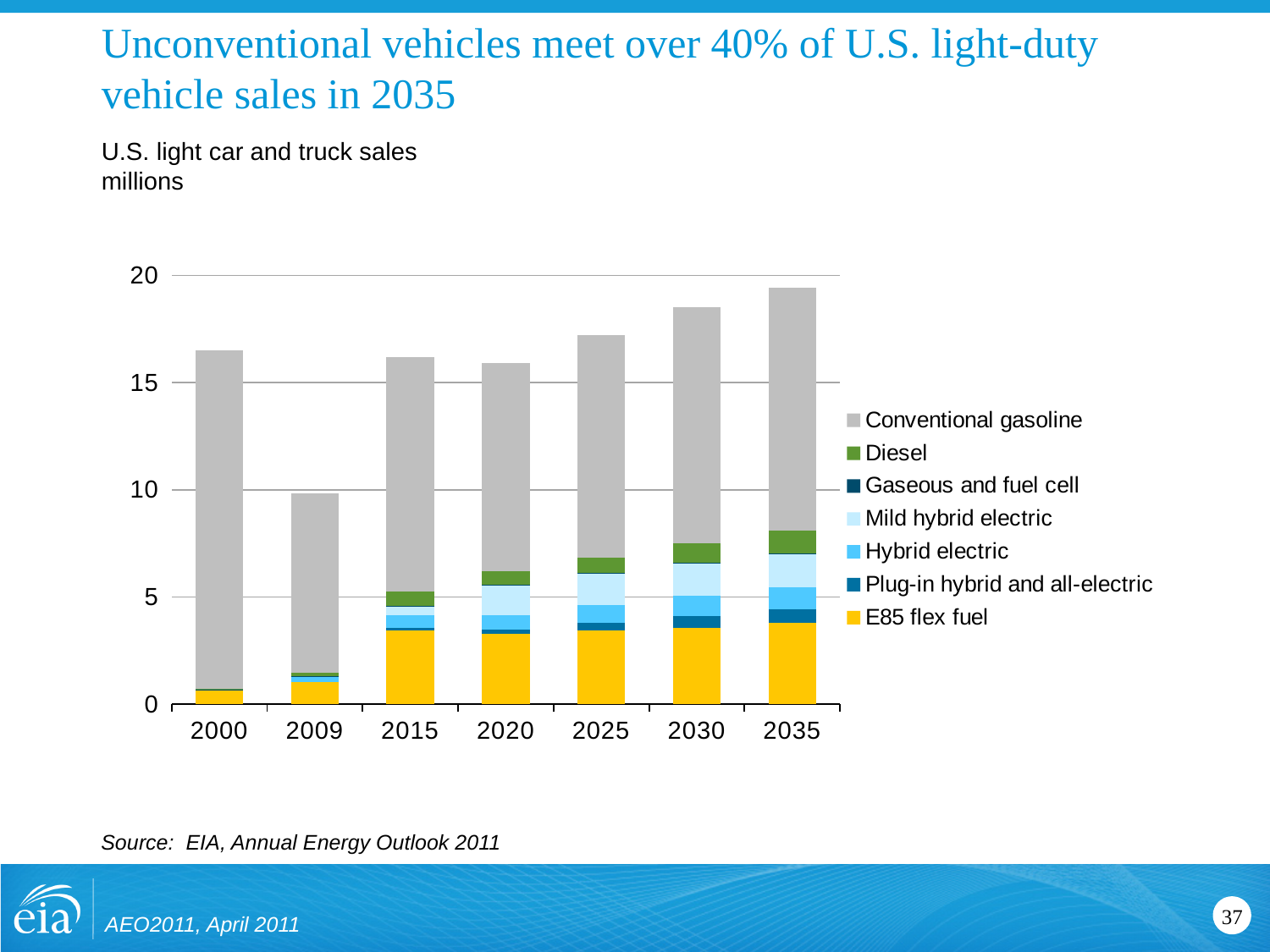
Do the total bars rise or fall from 2015 to 2035? Rise Is the total bar for 2000 greater or less than 15? greater Which year has the tallest total bar? 2035 Which series is shown in yellow at the bottom of each bar? E85 flex fuel What unit is the y axis of the chart measured in? millions Which year has the shortest total bar? 2009 How many years are shown on the x axis of the chart? 7 Which year has a larger total bar, 2020 or 2030? 2030 How many series does the chart's legend list? 7 What kind of chart is shown on the slide? Stacked bar chart Is the total bar for 2035 greater or less than 15? greater Is the total bar for 2009 greater or less than 10? less